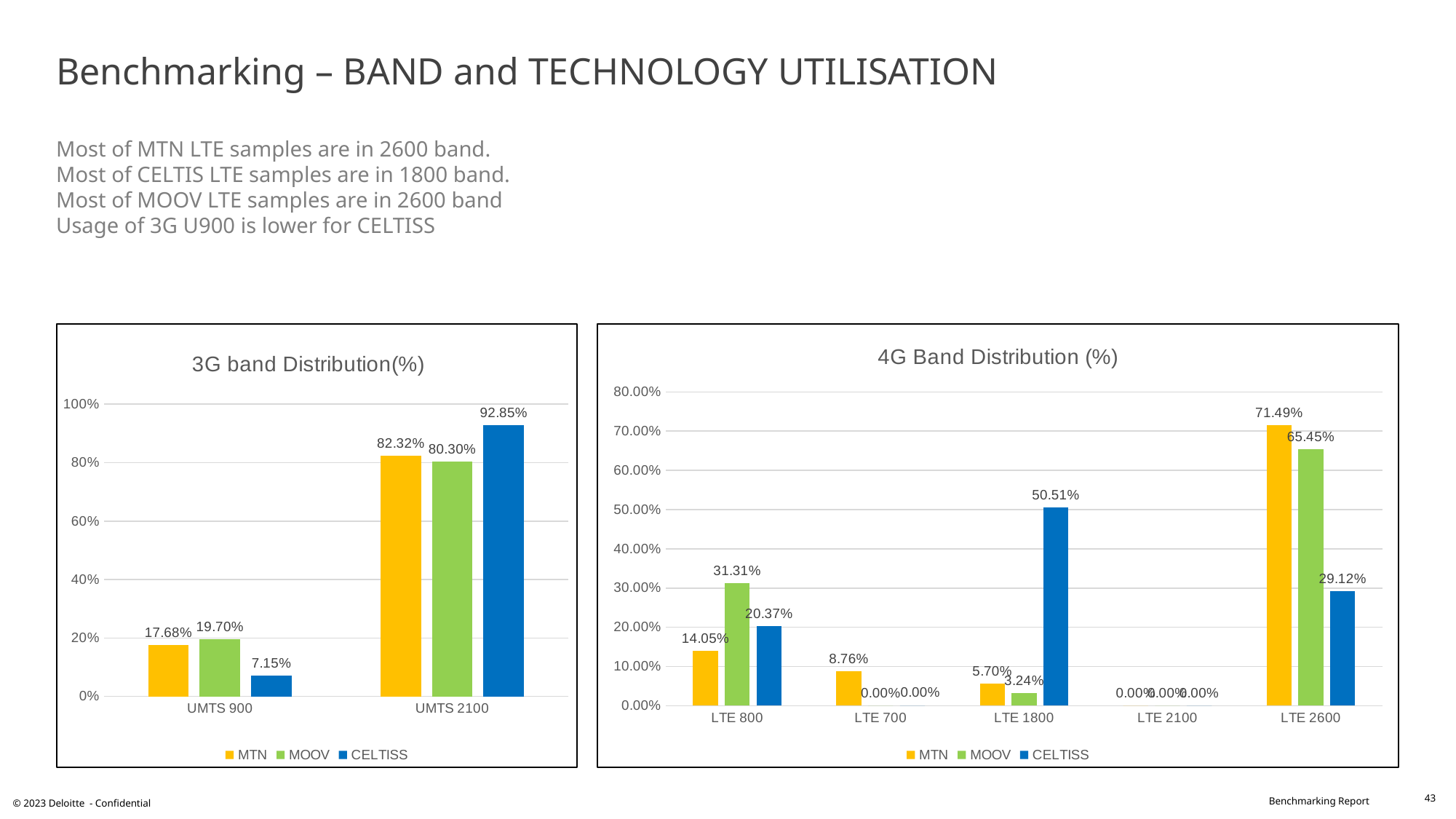
In the 3G band Distribution(%) chart, which series has the lowest value for UMTS 900? CELTISS In the 4G Band Distribution (%) chart, what is the MTN value for LTE 2600? 71.49% In the 4G Band Distribution (%) chart, what is the CELTISS value for LTE 1800? 50.51% In the 4G Band Distribution (%) chart, which series has the highest value for LTE 800? MOOV In the 3G band Distribution(%) chart, what is the CELTISS value for UMTS 2100? 92.85% How many band categories are shown on the x axis of the 4G Band Distribution (%) chart? 5 How many series does the legend of the 3G band Distribution(%) chart list? 3 What type of chart is the 4G Band Distribution (%) chart? Bar chart In the 3G band Distribution(%) chart, what is the MOOV value for UMTS 900? 19.70% In the 4G Band Distribution (%) chart, is the MTN value for LTE 2600 larger than the MOOV value for LTE 2600? Yes In the 4G Band Distribution (%) chart, what is the difference between the MTN and MOOV values for LTE 2600? 6.04% In the 3G band Distribution(%) chart, what is the difference between the MTN and CELTISS values for UMTS 900? 10.53%